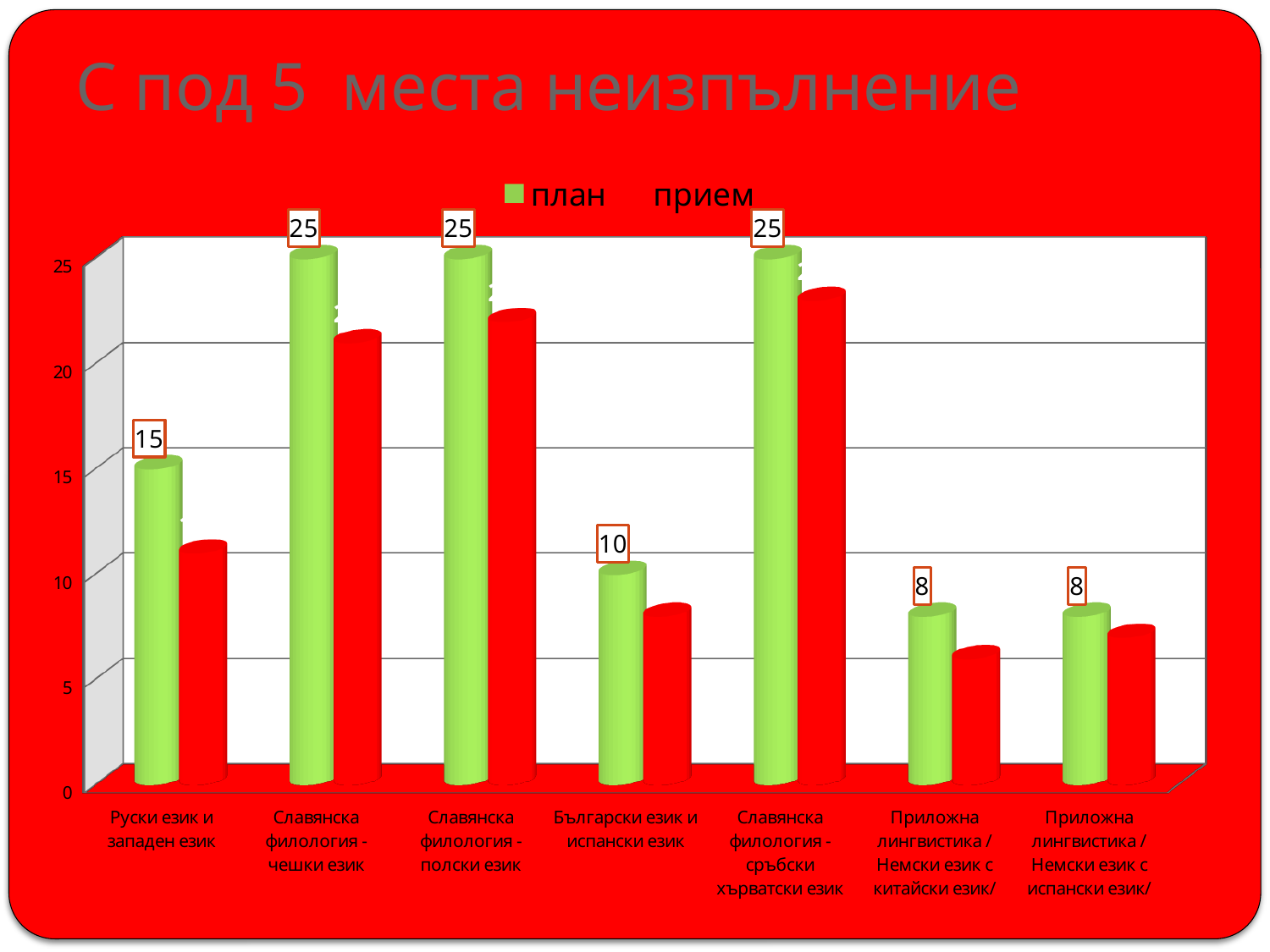
How many series does the legend list? 2 For Славянска филология - полски език, which is larger: план or прием? план What is the план value for Български език и испански език? 10 Is the прием value for Български език и испански език greater or less than 10? less How many categories are shown on the x axis? 7 What is the план value for Руски език и западен език? 15 Is the прием value for Приложна лингвистика / Немски език с китайски език/ greater or less than 5? greater What is the план value for Славянска филология - сръбски хърватски език? 25 Is the прием value for Славянска филология - сръбски хърватски език greater or less than 20? greater What is the план value for Приложна лингвистика / Немски език с китайски език/? 8 What is the difference between the план values for Славянска филология - чешки език and Руски език и западен език? 10 What kind of chart is shown on the slide? bar chart